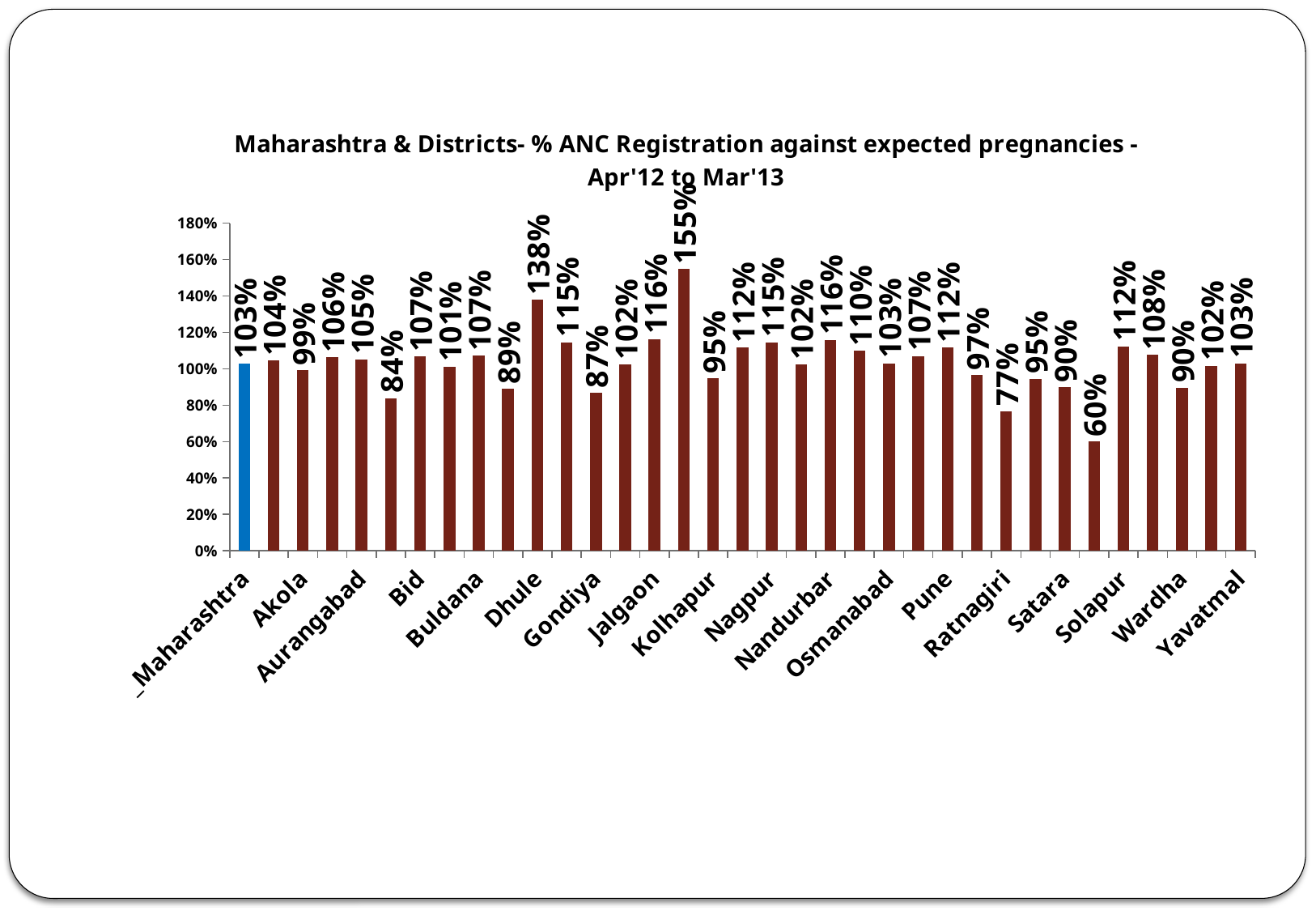
What is the % ANC registration value for Maharashtra? 103% What is the highest value shown on the chart? 155% Is the value for Ratnagiri greater or less than 100%? less What is the title of the chart? Maharashtra & Districts- % ANC Registration against expected pregnancies - Apr'12 to Mar'13 What colour is the bar for Maharashtra? Blue By how many percentage points does Dhule exceed Maharashtra? 35 percentage points What is the lowest value shown on the chart? 60% What is the % ANC registration value for Yavatmal? 103% What is the % ANC registration value for Ratnagiri? 77% What is the % ANC registration value for Dhule? 138% What type of chart is shown on the slide? Bar chart Which has a higher value, Dhule or Maharashtra? Dhule